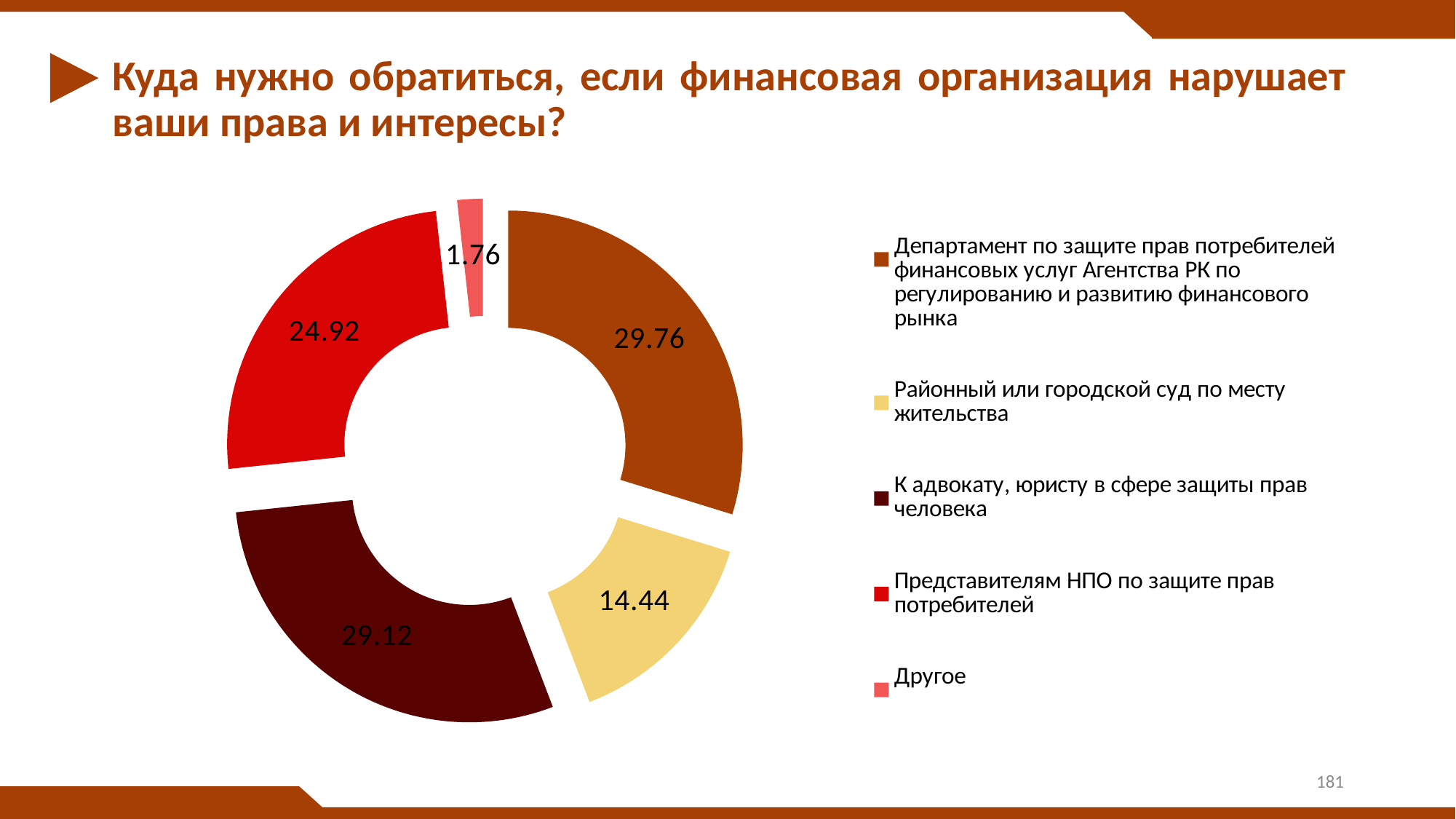
Which category has the smallest slice? Другое What is the value for «Районный или городской суд по месту жительства»? 14.44 Which is larger: the value for «К адвокату, юристу в сфере защиты прав человека» or for «Представителям НПО по защите прав потребителей»? К адвокату, юристу в сфере защиты прав человека What kind of chart is shown on the slide? Doughnut (pie) chart What is the value for «Другое»? 1.76 What is the value for «К адвокату, юристу в сфере защиты прав человека»? 29.12 What is the difference between the values for «Представителям НПО по защите прав потребителей» and «Районный или городской суд по месту жительства»? 10.48 What is the value for «Департамент по защите прав потребителей финансовых услуг Агентства РК по регулированию и развитию финансового рынка»? 29.76 Which category has the largest slice? Департамент по защите прав потребителей финансовых услуг Агентства РК по регулированию и развитию финансового рынка What colour is the slice for «Районный или городской суд по месту жительства»? Yellow How many categories does the legend list? 5 What is the value for «Представителям НПО по защите прав потребителей»? 24.92